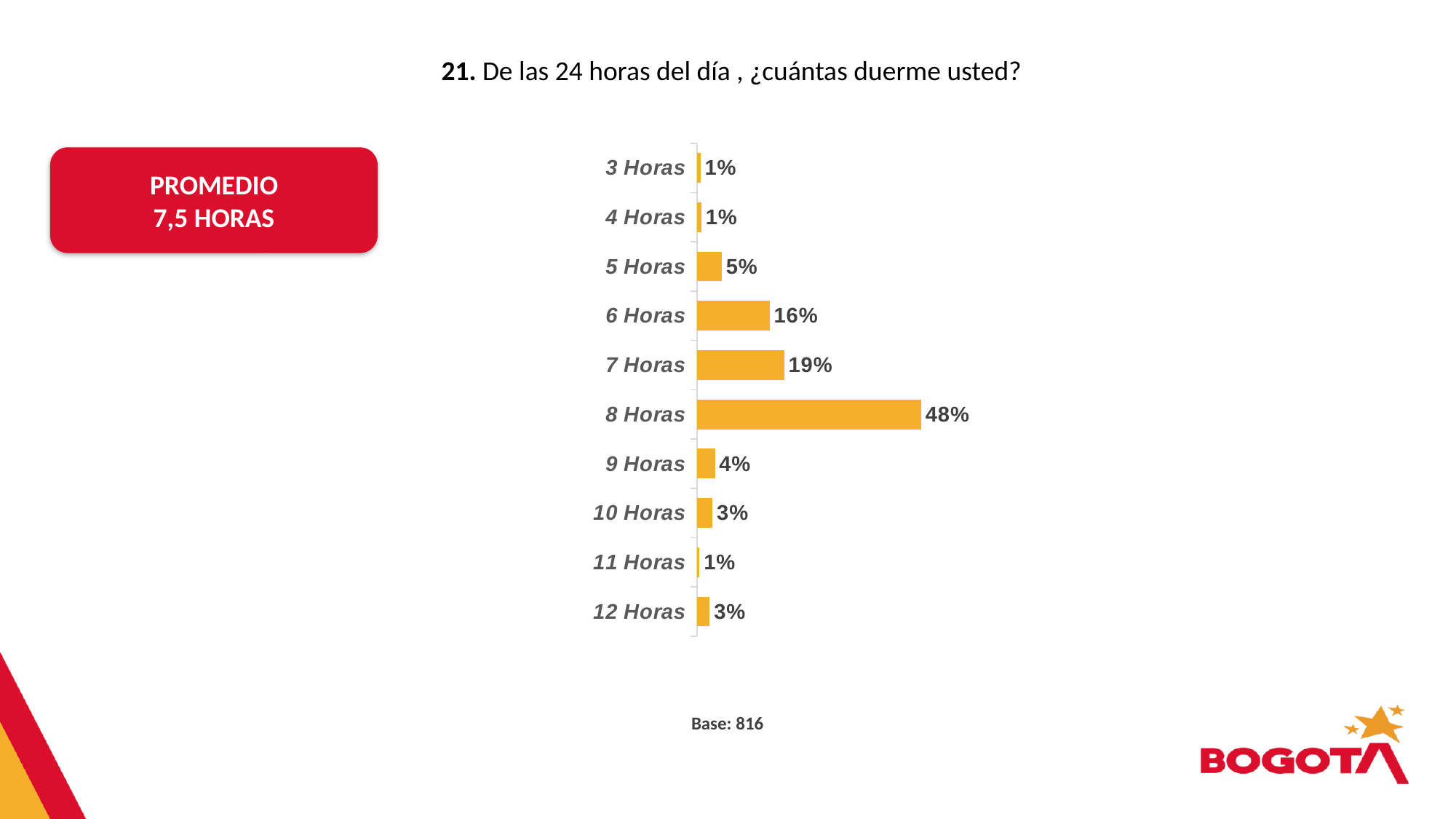
How many categories are shown in the chart? 10 What percentage is shown for 7 Horas? 19% What is the base (number of respondents) shown below the chart? 816 What is the difference between the values for 7 Horas and 6 Horas? 3% What is the value for 10 Horas? 3% Which is larger, the value for 9 Horas or the value for 5 Horas? 5 Horas What percentage of respondents sleep 8 hours? 48% What is the value shown for 6 Horas? 16% Which category has the highest value? 8 Horas What kind of chart is shown on the slide? Bar chart What average number of hours is shown in the red box? 7,5 HORAS What is the difference between the values for 8 Horas and 7 Horas? 29%